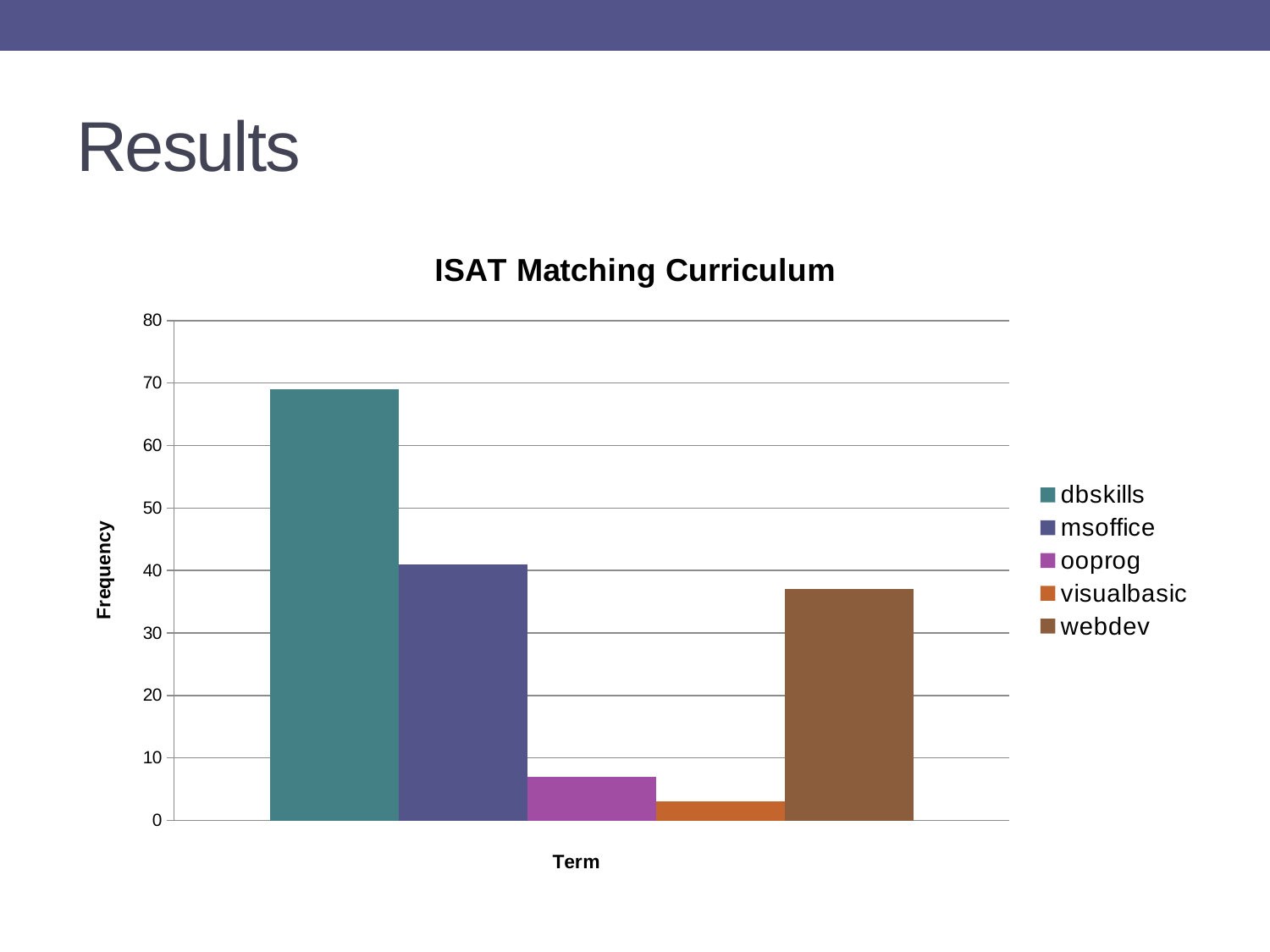
What is the label of the y axis? Frequency Which term has the highest frequency? dbskills Is the value for dbskills greater or less than 60? greater Is the value for ooprog greater or less than 10? less Which has a larger frequency, msoffice or webdev? msoffice What kind of chart is shown on the slide? bar chart How many bars are plotted in the chart? 5 Which term has the lowest frequency? visualbasic How many series does the legend list? 5 Is the value for webdev greater or less than 40? less What is the title of the chart? ISAT Matching Curriculum